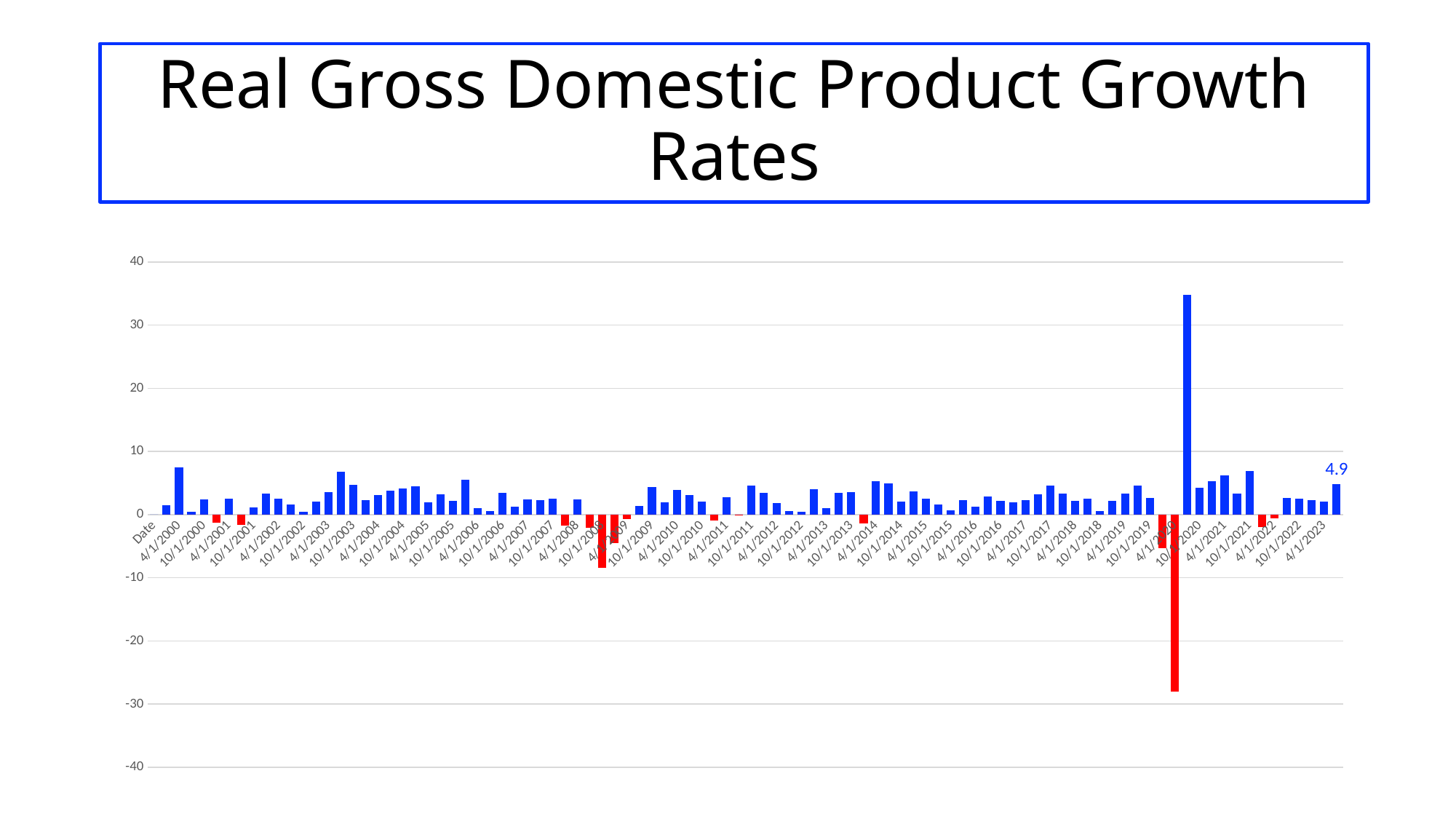
Is the value of the lowest (most negative) bar in the chart greater or less than -20? less What is the highest value shown on the vertical axis of the chart? 40 What colour are the bars with negative values in the chart? red In which year does the tallest bar in the chart occur? 2020 Is the value of the tallest bar in the chart greater or less than 30? greater What is the title of the chart on the slide? Real Gross Domestic Product Growth Rates What kind of chart is shown on the slide? bar chart In which year does the lowest (most negative) bar in the chart occur? 2020 Is the value of the rightmost bar (labelled 4.9) greater or less than 10? less What value is printed as a data label on the rightmost bar of the chart? 4.9